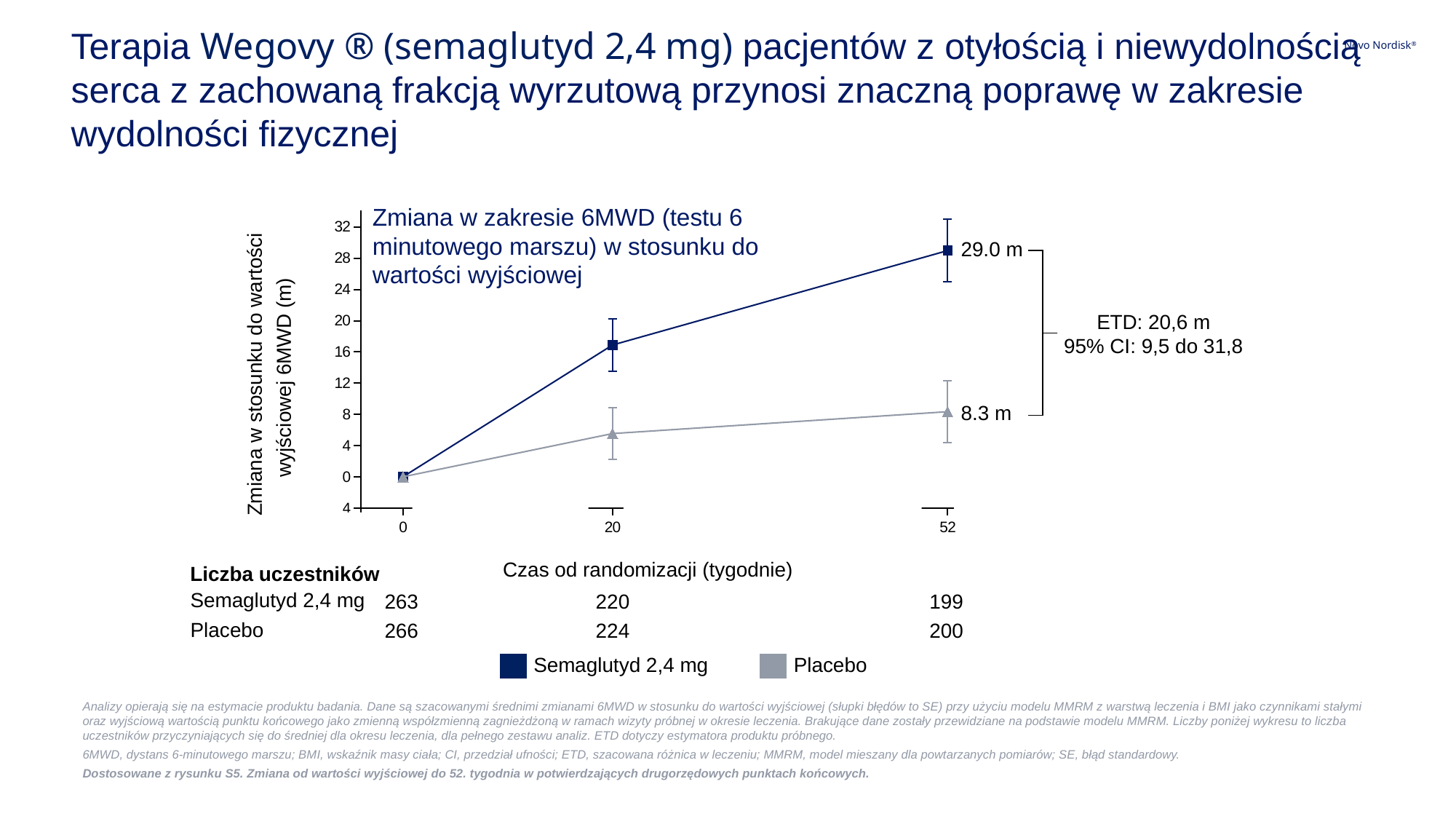
Is the value for Placebo at week 20 greater or less than 8? less How many time points are plotted on the x axis? 3 What is the ETD (estimated treatment difference) shown on the chart? ETD: 20,6 m How many series does the legend list? 2 Does the Semaglutyd 2,4 mg line rise or fall from week 0 to week 52? rise Which series has the higher value at week 52, Semaglutyd 2,4 mg or Placebo? Semaglutyd 2,4 mg Is the value for Semaglutyd 2,4 mg at week 20 greater or less than 12? greater What is the label of the x axis? Czas od randomizacji (tygodnie) What is the change in 6MWD for Semaglutyd 2,4 mg at week 52? 29.0 m What type of chart is shown on the slide? line chart What is the change in 6MWD for Placebo at week 52? 8.3 m What is the value for both series at week 0? 0